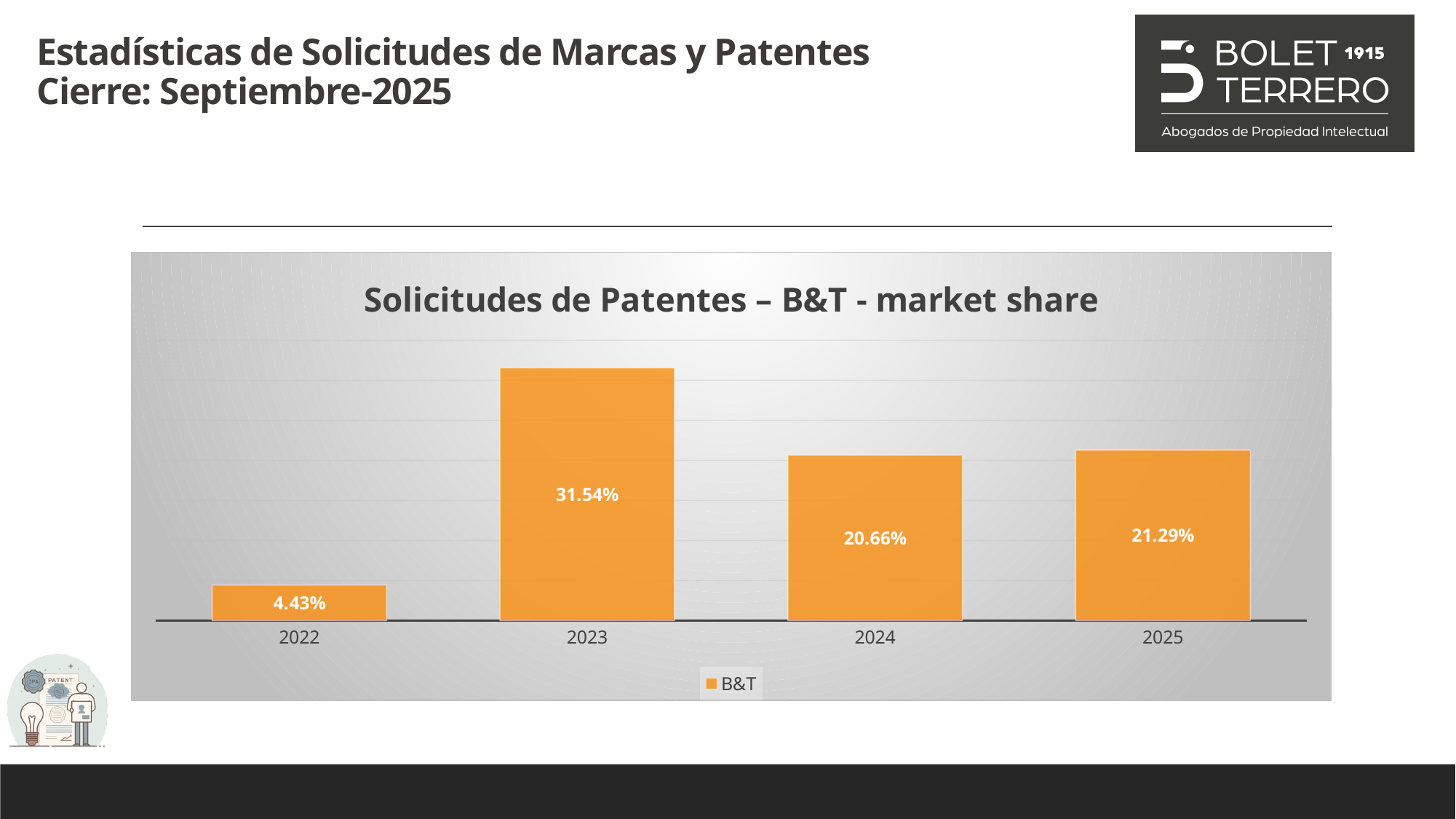
Which year has the lowest B&T market share? 2022 What is the title of the chart? Solicitudes de Patentes – B&T - market share What is the B&T market share value for 2025? 21.29% What is the difference between the 2025 and 2022 values? 16.86% What is the difference between the 2023 and 2024 values? 10.88% What kind of chart is shown? Bar chart How many series does the legend list? 1 What is the B&T market share value for 2023? 31.54% What is the B&T market share value for 2022? 4.43% Which is larger, the value for 2023 or the value for 2025? 2023 How many years are shown on the x axis? 4 Which year has the highest B&T market share? 2023